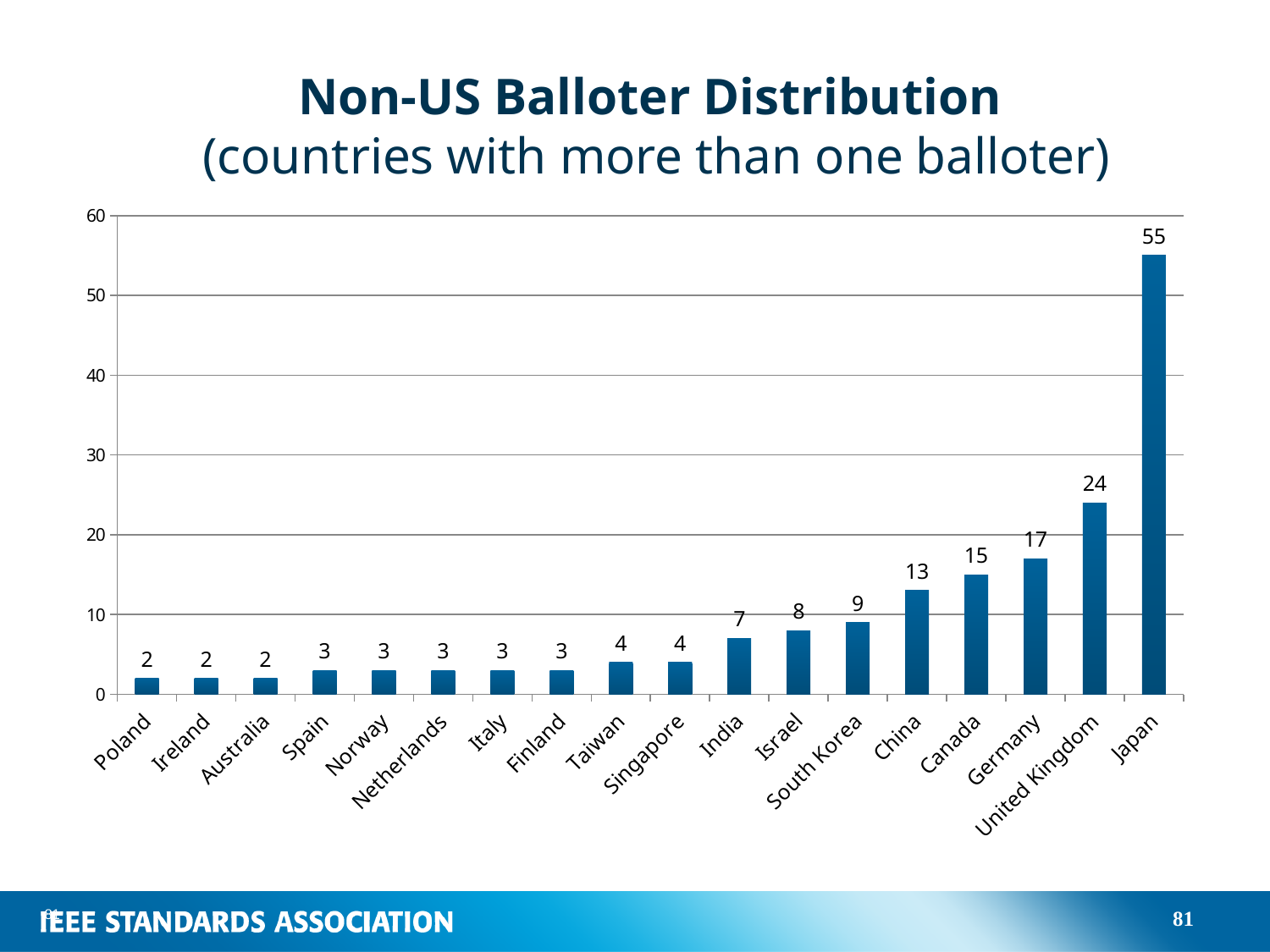
What is the value for South Korea? 9 What is the value for United Kingdom? 24 How many countries are shown on the chart? 18 What is the difference between the values for Germany and Canada? 2 What is the difference between the values for Japan and United Kingdom? 31 Is the value for Japan greater or less than 50? greater Which country has the highest value? Japan Do the values rise or fall from left to right along the x axis? rise What kind of chart is shown on the slide? bar chart Which is larger, the value for China or the value for Israel? China What is the title of the chart? Non-US Balloter Distribution (countries with more than one balloter) What is the value for Japan? 55